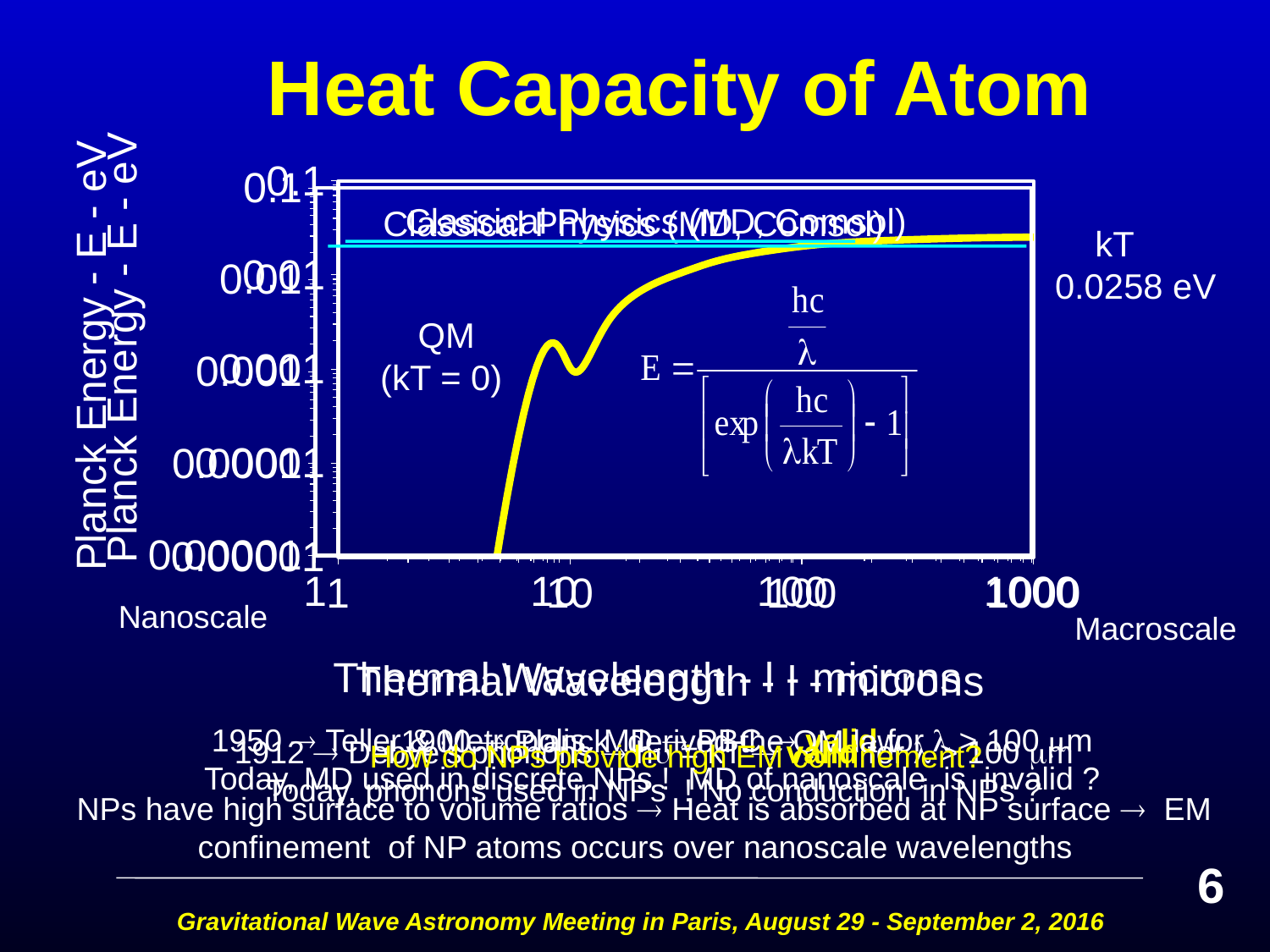
What is the title of the slide containing the chart? Heat Capacity of Atom What value of kT is annotated next to the horizontal line on the chart? 0.0258 eV Which scale label appears at the right (large wavelength) end of the x axis? Macroscale What kind of chart is shown on the slide? line chart What is the largest thermal wavelength labeled on the x axis of the chart? 1000 Does the yellow Planck energy curve rise or fall as the thermal wavelength increases along the x axis? rises How many labeled tick values are shown on the x axis of the chart? 4 What quantity is plotted on the x axis of the chart? Thermal Wavelength - l - microns Which scale label appears at the left (small wavelength) end of the x axis? Nanoscale Is the Planck energy at a thermal wavelength of 1000 microns greater or less than 0.01? greater